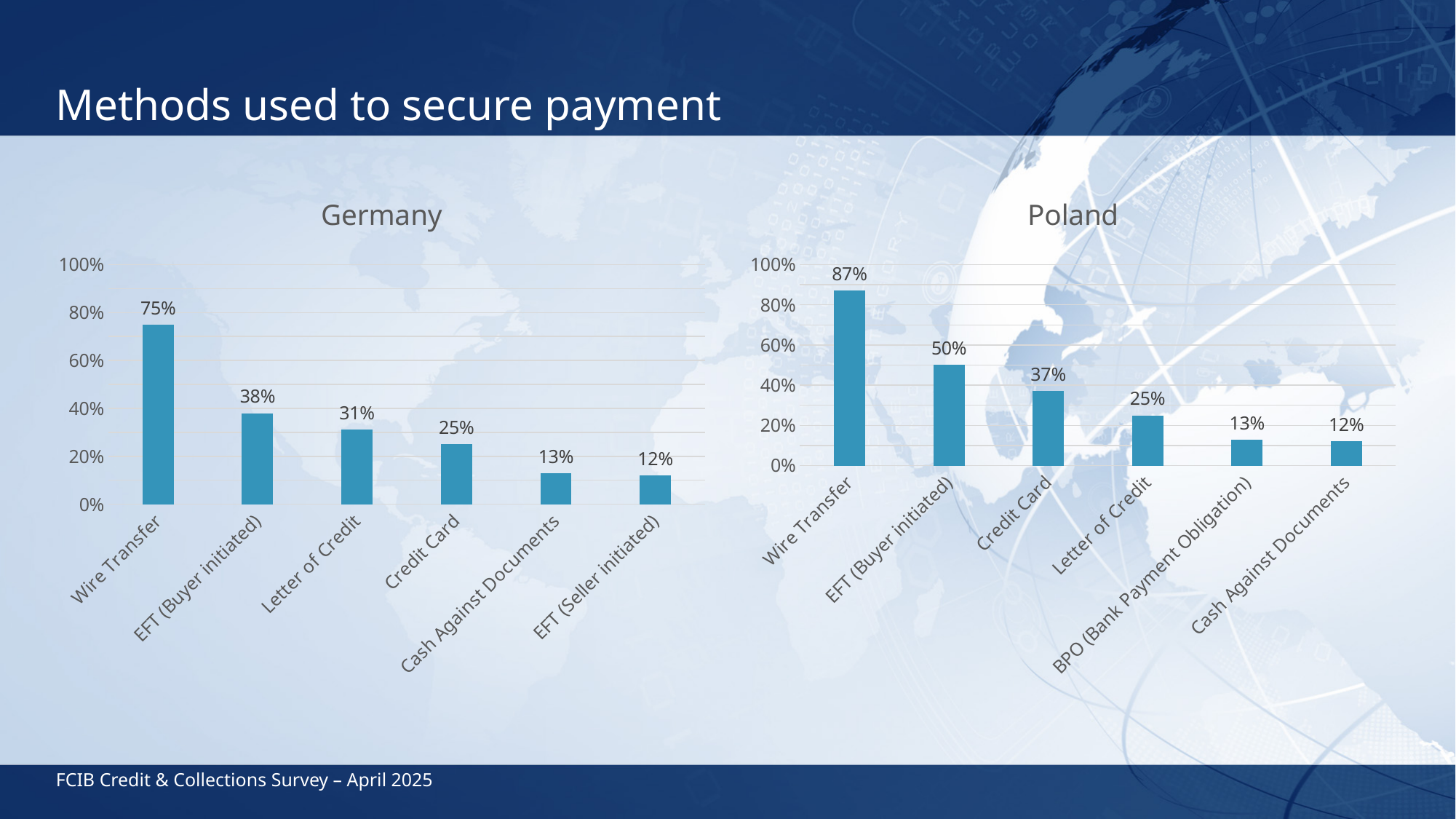
In the Germany chart, what is the difference between Wire Transfer and EFT (Buyer initiated)? 37% In the Germany chart, which category has the highest value? Wire Transfer In the Poland chart, what is the value for BPO (Bank Payment Obligation)? 13% What kind of chart is the Germany chart? bar chart In the Poland chart, do the values rise or fall from left to right along the x axis? fall In the Germany chart, what is the value for Wire Transfer? 75% In the Poland chart, what is the difference between Credit Card and Letter of Credit? 12% In the Poland chart, what is the value for EFT (Buyer initiated)? 50% Which is larger: Wire Transfer in the Germany chart or Wire Transfer in the Poland chart? Poland In the Poland chart, which category has the lowest value? Cash Against Documents How many categories are shown in the Poland chart? 6 In the Germany chart, is the value for Letter of Credit greater or less than 40%? less